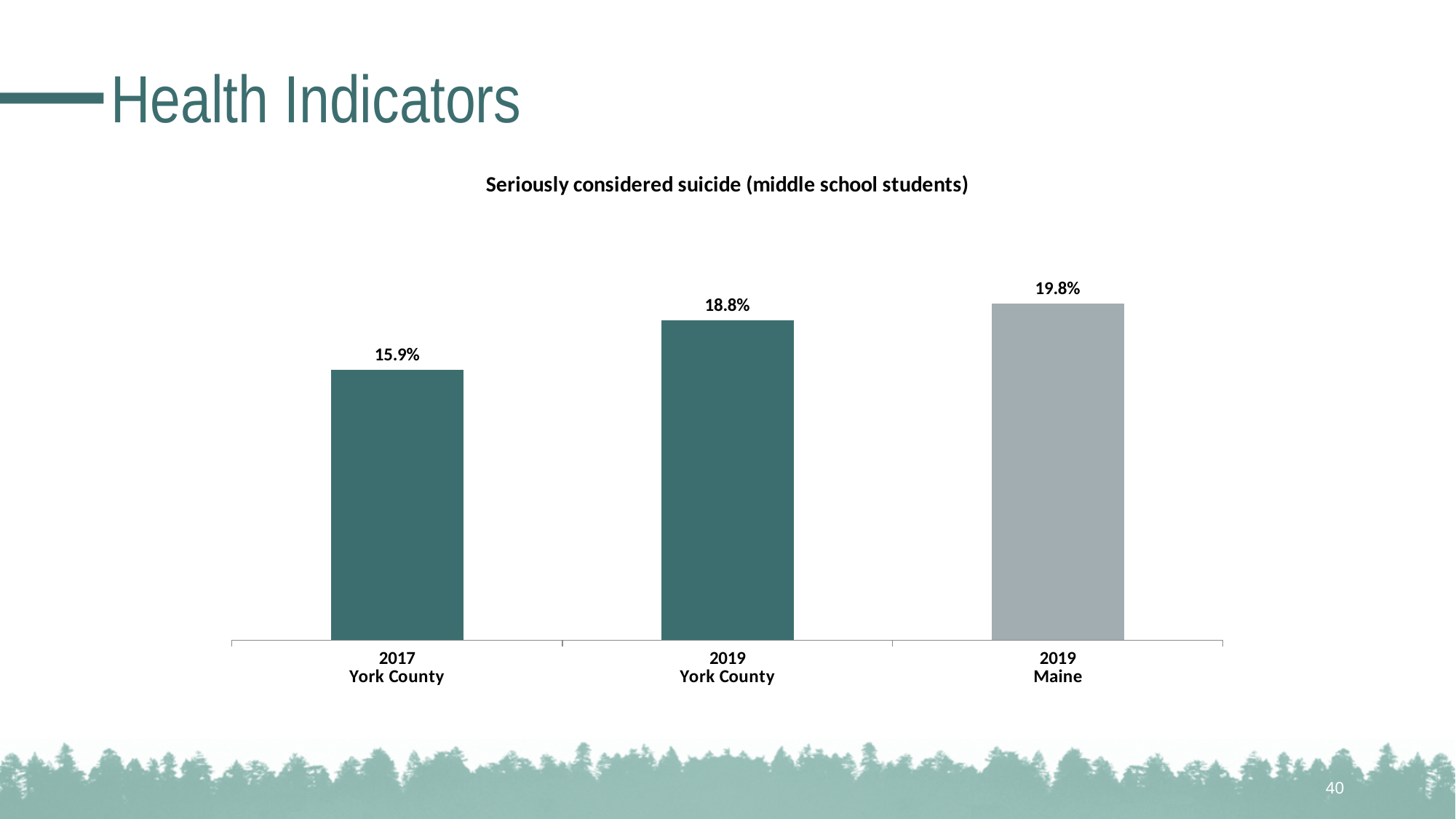
What is the value for 2017 York County? 15.9% Which category has the highest value? 2019 Maine What is the difference between the 2019 Maine value and the 2019 York County value? 1.0% Which category has the lowest value? 2017 York County What is the title of the chart? Seriously considered suicide (middle school students) Did the York County value rise or fall from 2017 to 2019? Rise What is the value for 2019 Maine? 19.8% Which is larger, the value for 2019 Maine or the value for 2019 York County? 2019 Maine How many bars are shown in the chart? 3 What is the difference between the 2019 York County value and the 2017 York County value? 2.9% What kind of chart is shown on the slide? Bar chart What is the value for 2019 York County? 18.8%